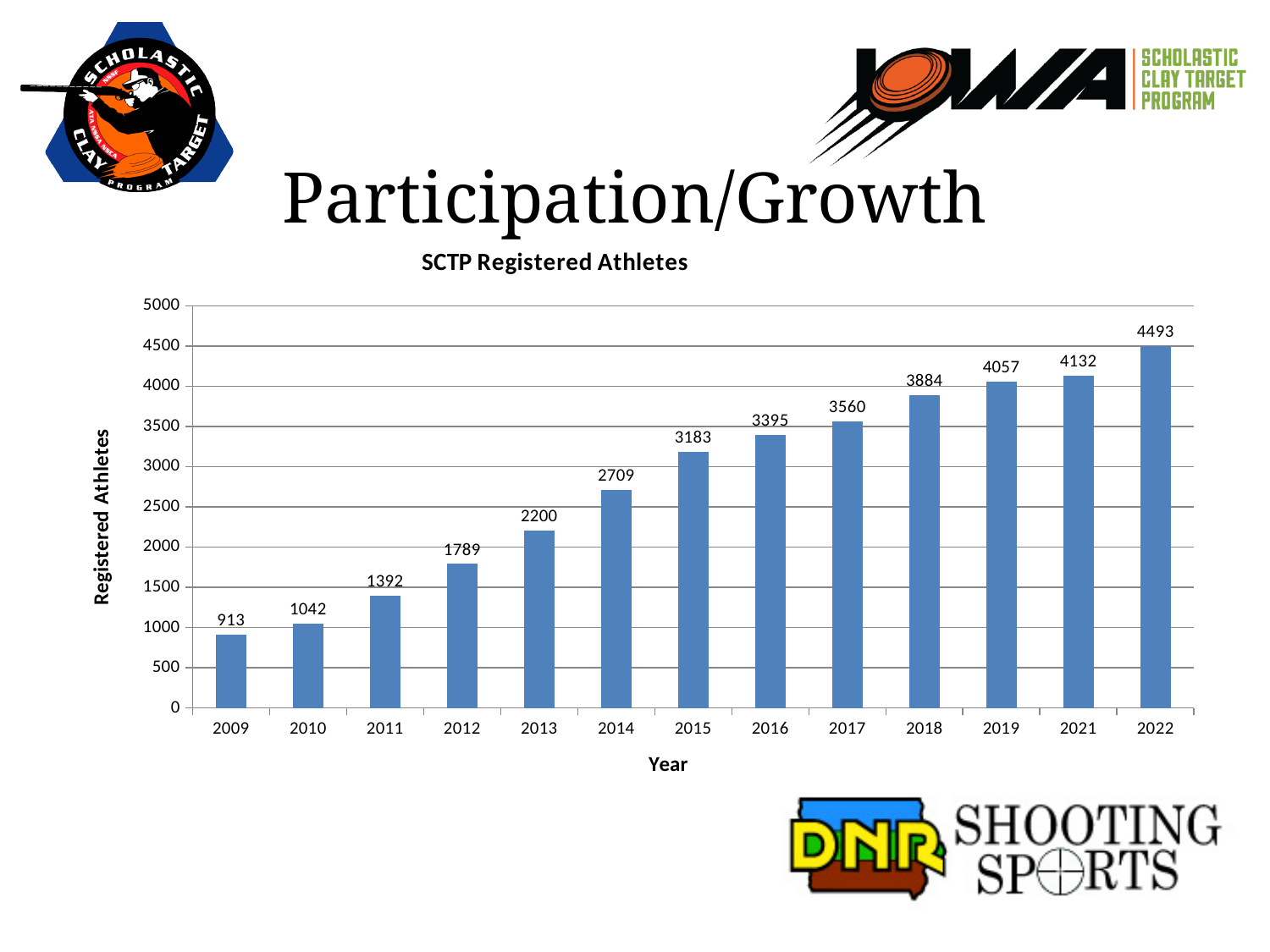
Which year has the lowest number of registered athletes? 2009 Do the values rise or fall from 2009 to 2022? Rise Which year has the highest number of registered athletes? 2022 What is the number of SCTP registered athletes in 2014? 2709 Is the value for 2015 greater or less than 3000? greater What kind of chart is shown on the slide? Bar chart Which year had more registered athletes, 2016 or 2017? 2017 How many years are shown on the x axis of the chart? 13 What is the difference in registered athletes between 2013 and 2012? 411 What is the number of SCTP registered athletes in 2009? 913 What is the difference in registered athletes between 2022 and 2021? 361 What is the number of SCTP registered athletes in 2019? 4057